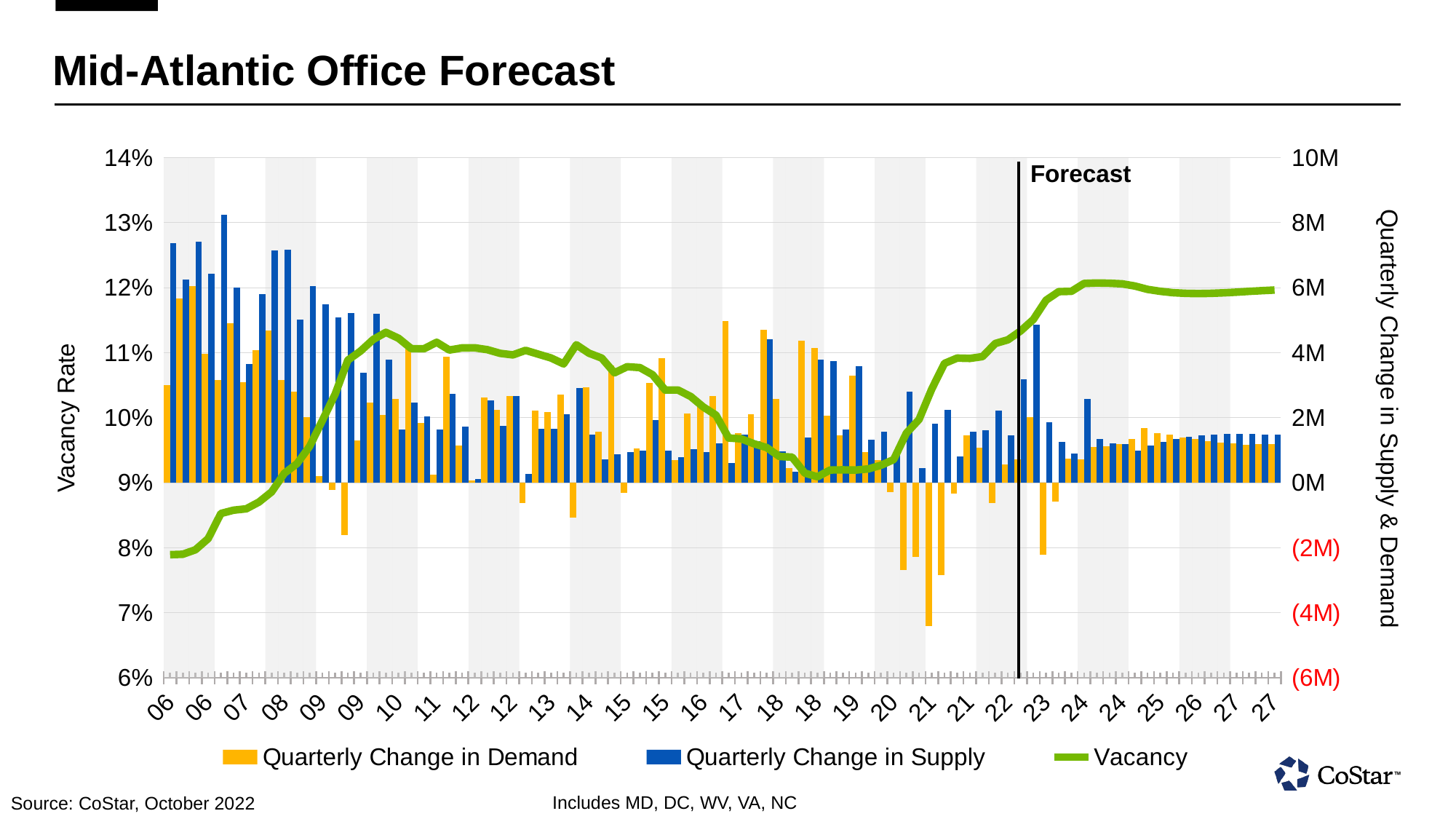
Does the Vacancy line rise or fall between 2010 and 2018? Falls Does the Vacancy line rise or fall between 2020 and 2024? Rises Is the largest Quarterly Change in Supply bar (around 2006) greater or less than 6M? greater Is the Vacancy value in 2007 greater or less than 9%? less What kind of chart is shown on the slide? A combination bar and line chart Is the Vacancy value in 2018 greater or less than 10%? less What is the title of the chart? Mid-Atlantic Office Forecast How many series does the legend list? 3 Which series is plotted as a green line? Vacancy Which is higher, the Vacancy rate in 2024 or in 2006? 2024